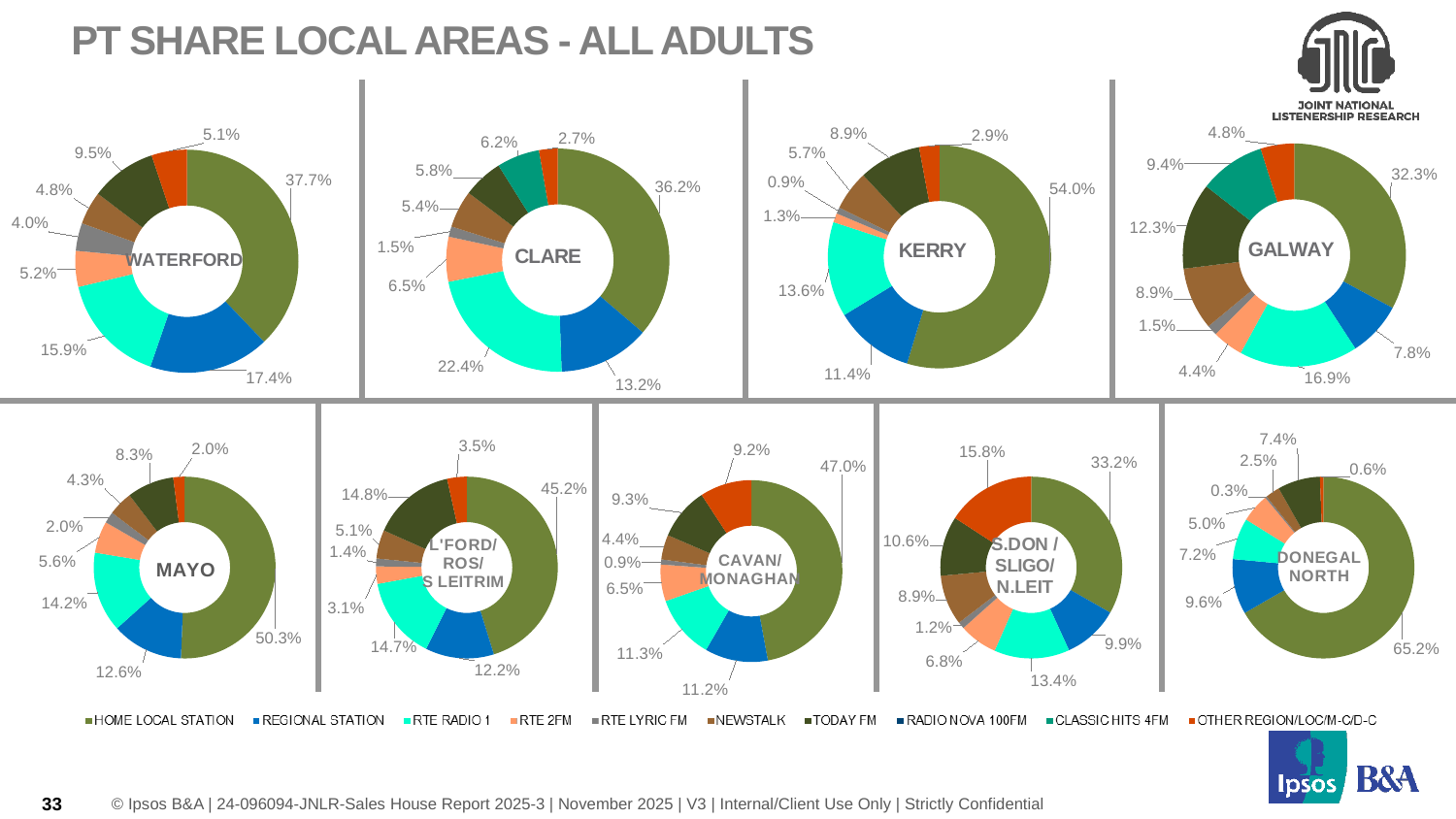
In the DONEGAL NORTH chart, what is the value of the largest slice? 65.2% In the WATERFORD chart, what is the share of the largest slice? 37.7% In the CLARE chart, what is the difference between the largest slice (36.2%) and the second largest slice (22.4%)? 13.8% How many series does the legend list? 10 What is the title of the slide? PT SHARE LOCAL AREAS - ALL ADULTS How many doughnut charts are shown on the slide? 9 In the S.DON / SLIGO / N.LEIT chart, what is the value of the largest slice? 33.2% In the DONEGAL NORTH chart, what is the value of the smallest slice? 0.3% In the CAVAN/MONAGHAN chart, what is the value of the largest slice? 47.0% What type of charts are shown on the slide? Doughnut (pie) charts Which chart has the larger largest slice, GALWAY or MAYO? MAYO